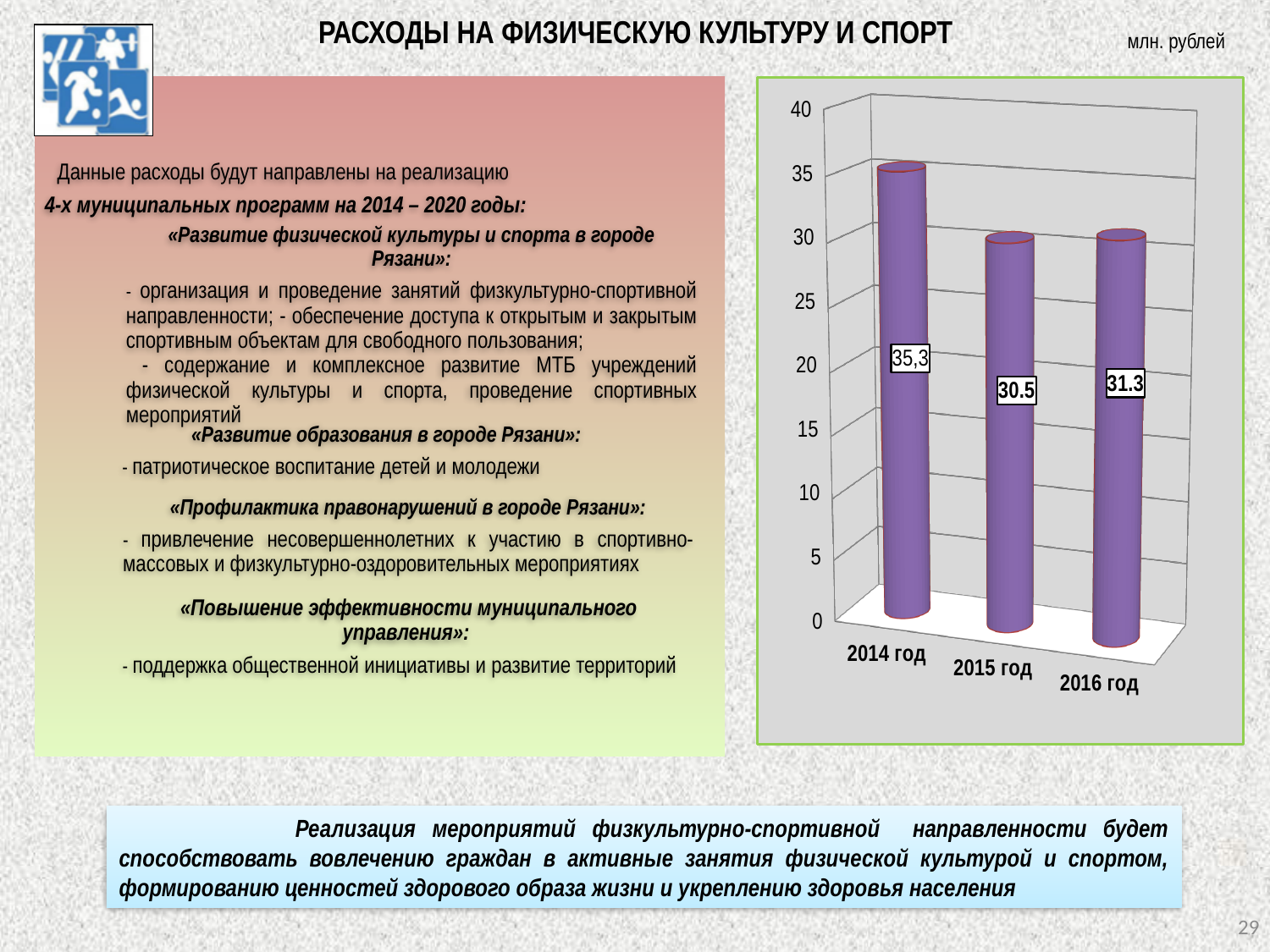
What kind of chart is shown on the slide? bar chart Which year has the lowest value? 2015 год Do the values rise or fall from 2014 год to 2015 год? fall What is the value for 2015 год? 30.5 How many years are shown on the chart? 3 What is the difference between the values for 2016 год and 2015 год? 0.8 What unit of measurement is indicated for the chart? млн. рублей What is the value for 2016 год? 31.3 Is the value for 2014 год greater or less than 30? greater Which is larger, the value for 2014 год or the value for 2016 год? 2014 год What is the value for 2014 год? 35,3 Which year has the highest value? 2014 год